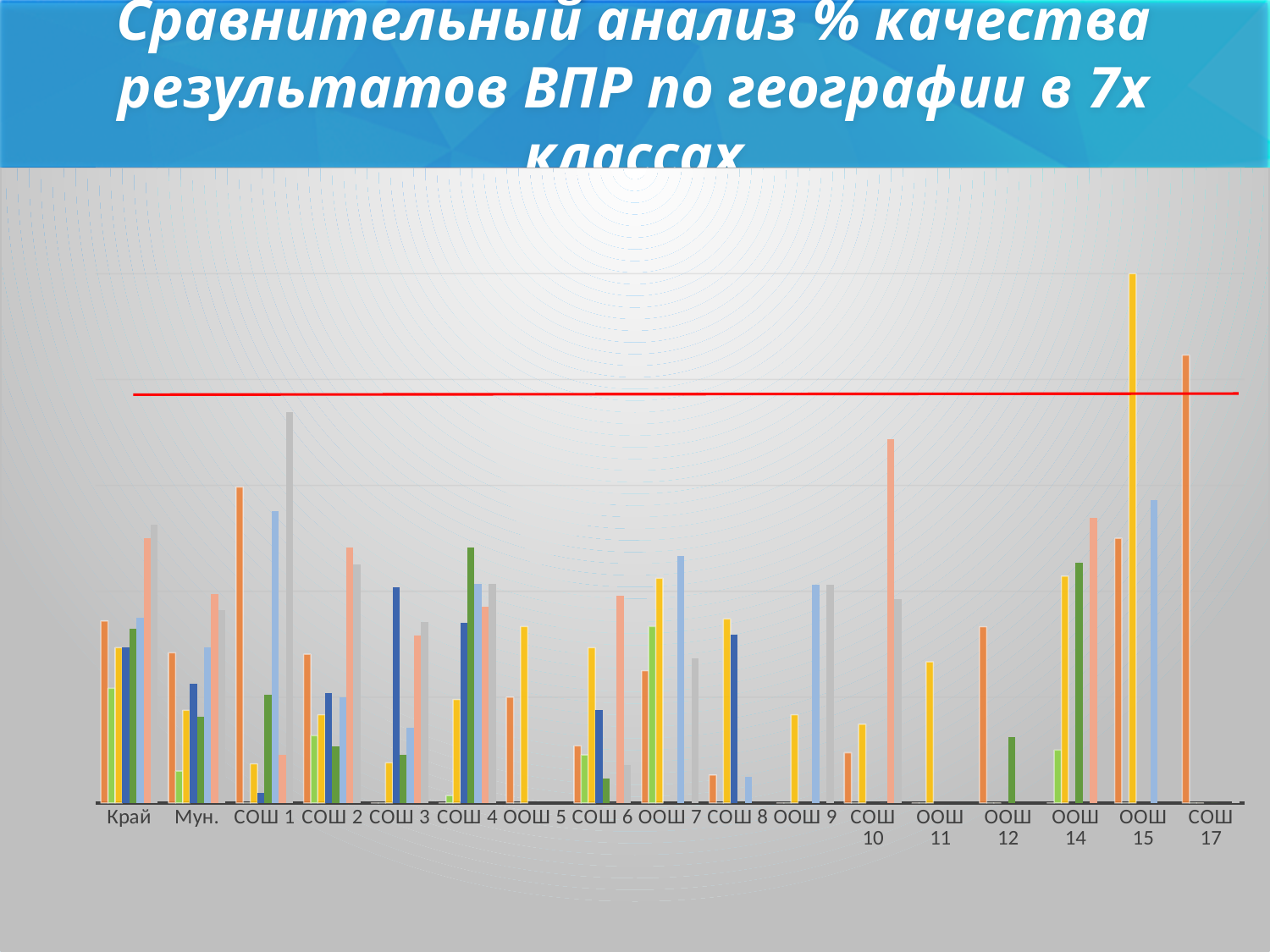
What kind of chart is shown on the slide? bar chart What is the title of the chart on the slide? Сравнительный анализ % качества результатов ВПР по географии в 7х классах Which category contains the tallest bar in the chart? ООШ 15 How many categories are shown along the x axis of the chart? 17 What is the first category on the x axis of the chart? Край Which category is the last one on the x axis of the chart? СОШ 17